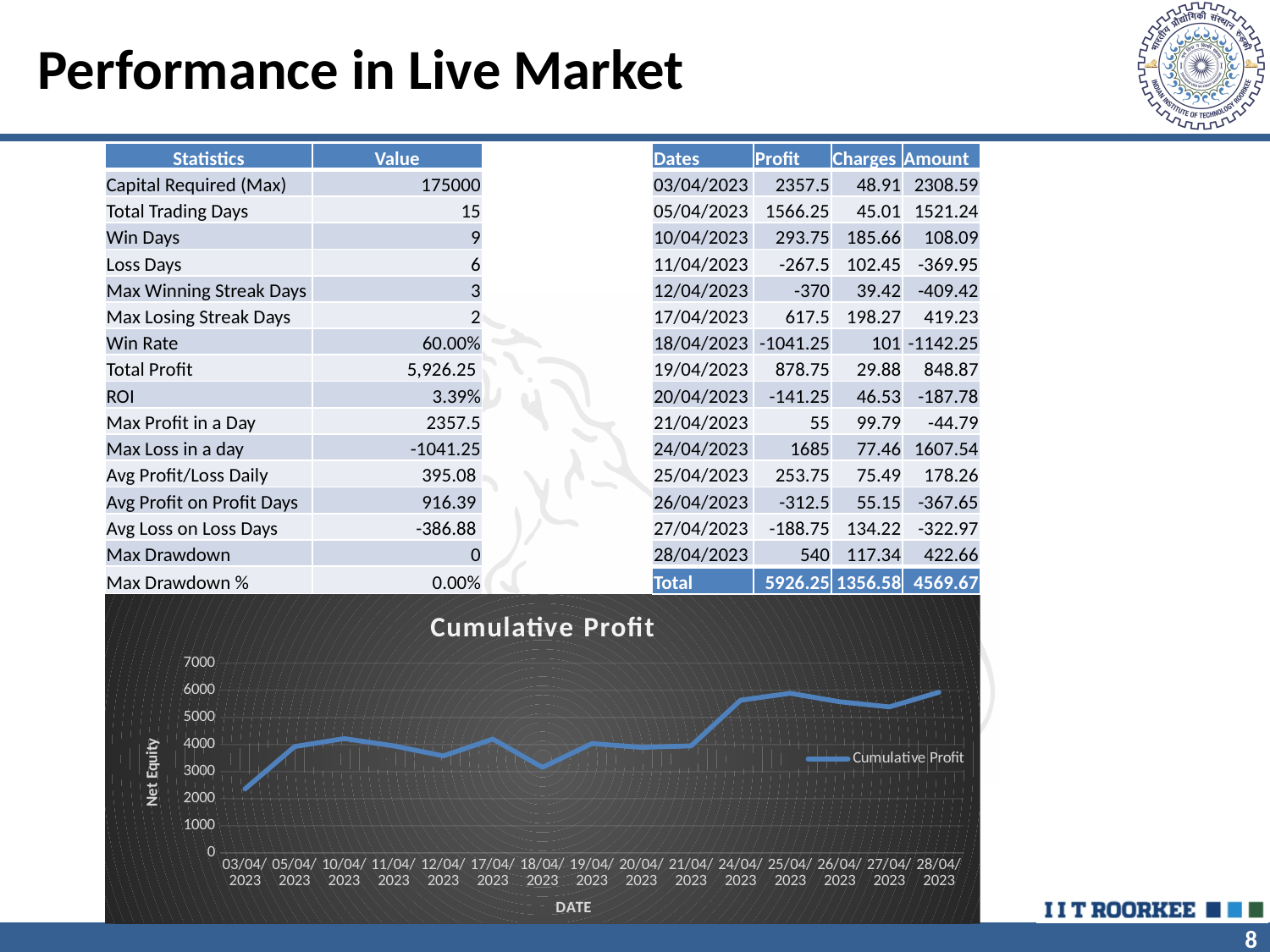
In the Cumulative Profit chart, which date has the lowest cumulative profit? 03/04/2023 In the Cumulative Profit chart, does the cumulative profit overall rise or fall from 03/04/2023 to 28/04/2023? rise In the Cumulative Profit chart, which is larger: the value for 17/04/2023 or the value for 18/04/2023? 17/04/2023 In the Cumulative Profit chart, is the value for 03/04/2023 greater or less than 3000? less What is the label on the x axis of the Cumulative Profit chart? DATE What kind of chart is shown under the title "Cumulative Profit"? line chart How many dates are plotted along the x axis of the Cumulative Profit chart? 15 How many series does the legend of the Cumulative Profit chart list? 1 What is the label on the y axis of the Cumulative Profit chart? Net Equity In the Cumulative Profit chart, is the value for 24/04/2023 greater or less than 5000? greater In the Cumulative Profit chart, is the value for 12/04/2023 greater or less than 4000? less